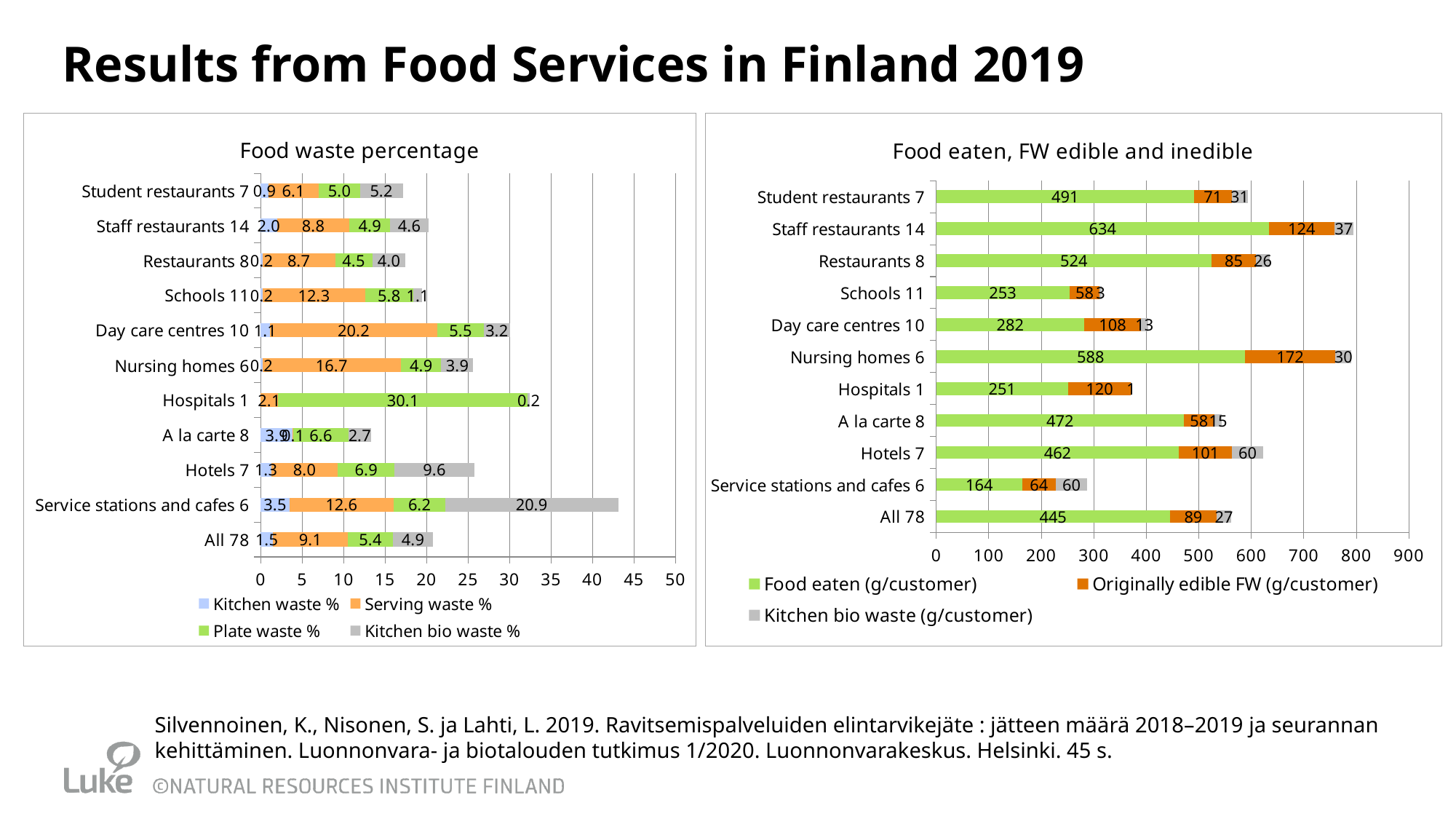
In the 'Food waste percentage' chart, which category has the highest Kitchen bio waste %? Service stations and cafes 6 In the 'Food eaten, FW edible and inedible' chart, which has the larger Originally edible FW value: Hospitals 1 or Day care centres 10? Hospitals 1 In the 'Food eaten, FW edible and inedible' chart, what is the difference in Food eaten between Staff restaurants 14 and Student restaurants 7? 143 How many series does the legend of the 'Food waste percentage' chart list? 4 How many categories are shown in the 'Food waste percentage' chart? 11 In the 'Food eaten, FW edible and inedible' chart, what is the Originally edible FW value for Nursing homes 6? 172 In the 'Food eaten, FW edible and inedible' chart, what is the Food eaten value for Staff restaurants 14? 634 In the 'Food waste percentage' chart, what is the Serving waste % for Day care centres 10? 20.2 In the 'Food waste percentage' chart, what is the Kitchen bio waste % for Service stations and cafes 6? 20.9 In the 'Food eaten, FW edible and inedible' chart, what is the total of the stacked bar for All 78? 561 In the 'Food eaten, FW edible and inedible' chart, which category has the lowest Food eaten value? Service stations and cafes 6 In the 'Food waste percentage' chart, what is the Plate waste % for Hotels 7? 6.9